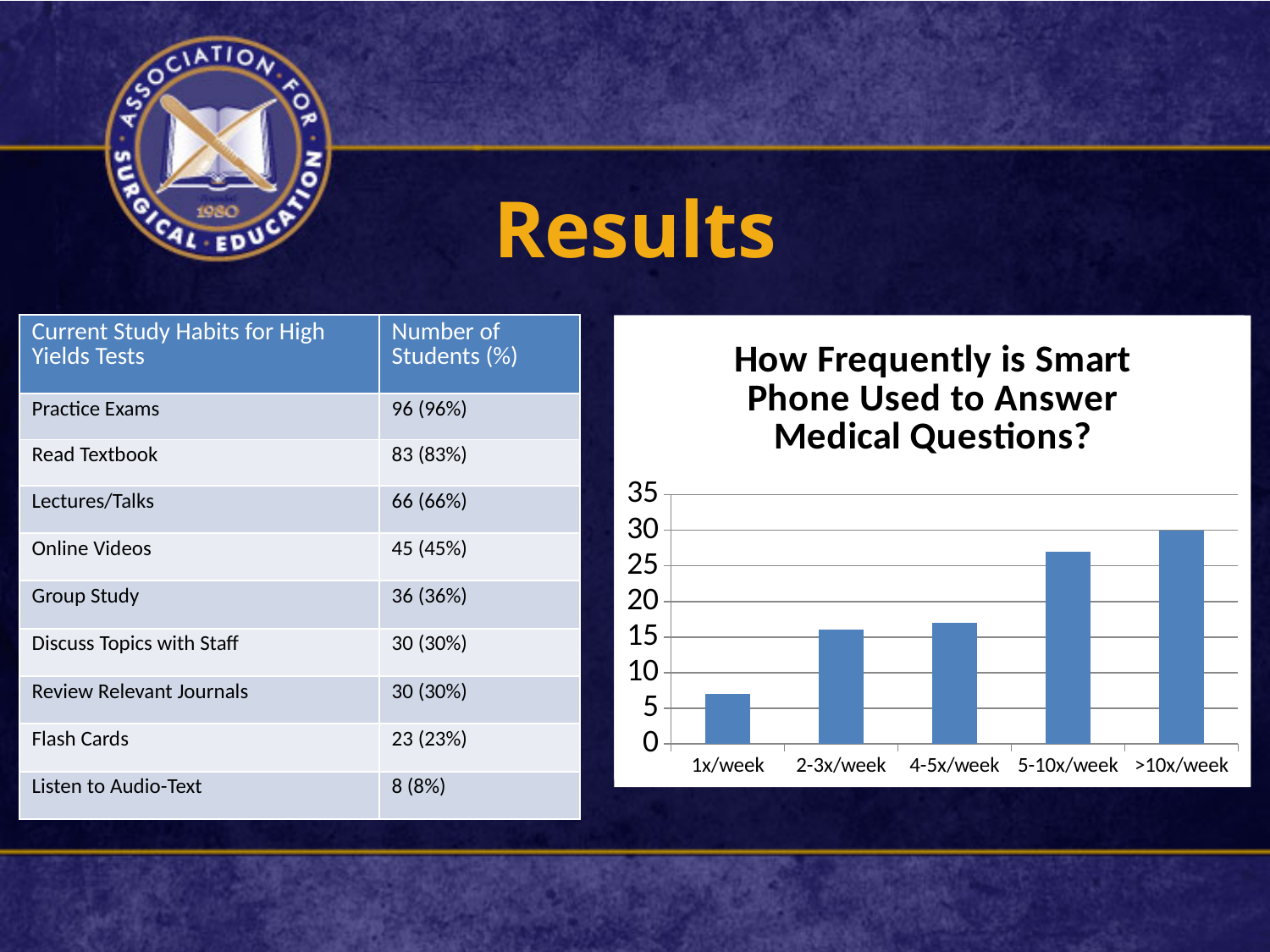
Is the value for 5-10x/week greater or less than 25? greater Which category has the highest bar in the chart? >10x/week Do the bar values rise or fall from 1x/week to >10x/week along the x axis? rise What is the title of the chart? How Frequently is Smart Phone Used to Answer Medical Questions? What is the value for >10x/week in the chart? 30 What kind of chart is shown on the slide? bar chart Is the value for 2-3x/week greater or less than 10? greater How many categories are shown on the x axis of the chart? 5 Which is larger, the value for 5-10x/week or the value for 2-3x/week? 5-10x/week Which category has the lowest bar in the chart? 1x/week Is the value for 1x/week greater or less than 10? less